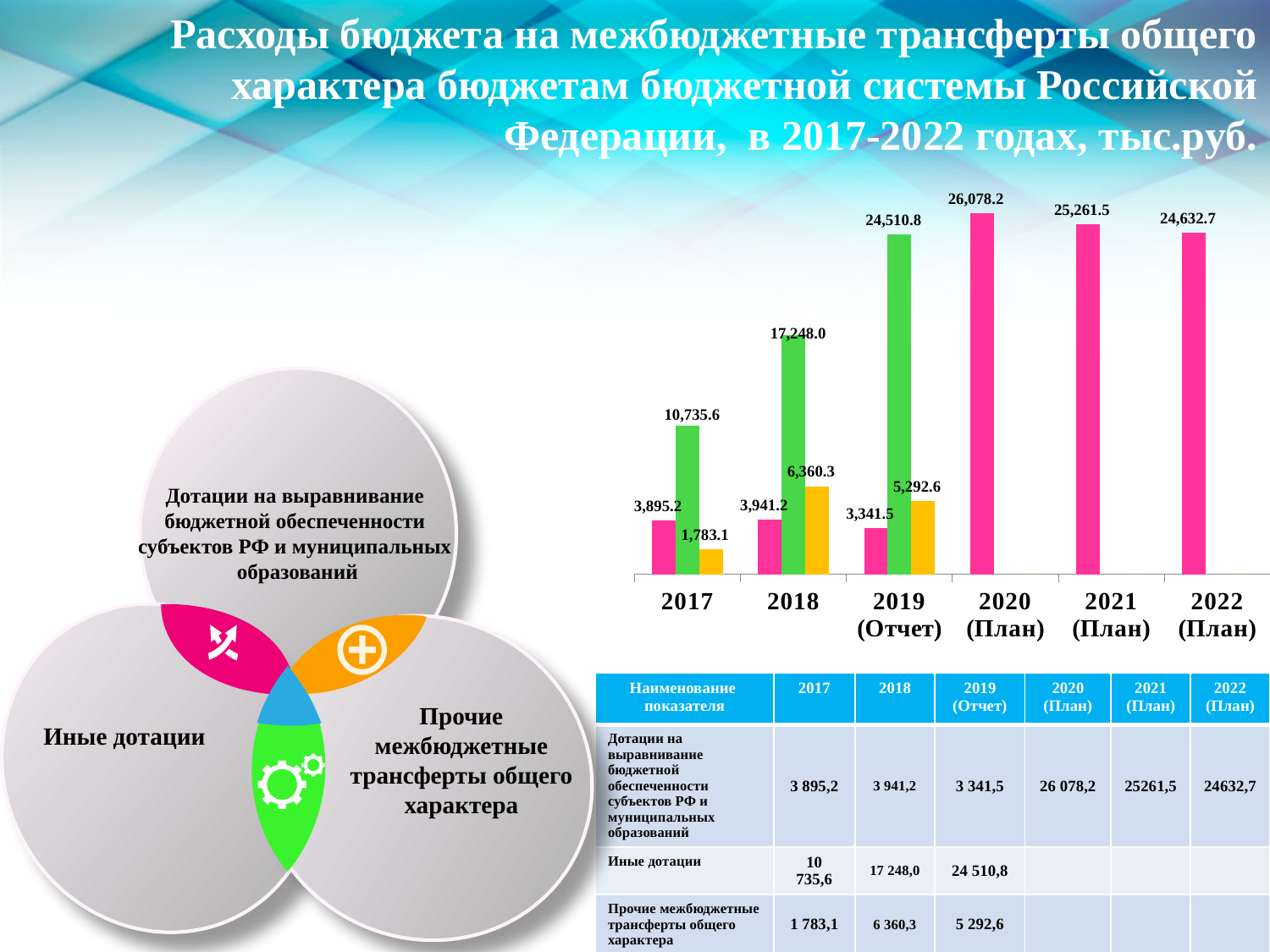
How many year categories are shown on the x axis of the chart? 6 What is the total of the three bars for 2017? 16,413.9 Which is larger: the pink bar for 2021 (План) or the pink bar for 2022 (План)? 2021 (План) Which year has the highest pink bar? 2020 (План) Do the green bar values rise or fall from 2017 to 2019 (Отчет)? rise What kind of chart is shown on the slide? bar chart What is the value of the yellow bar for 2018? 6,360.3 What is the value of the green bar for 2017? 10,735.6 Which year has the lowest yellow bar? 2017 What is the value of the pink bar for 2019 (Отчет)? 3,341.5 What is the difference between the green bar values for 2019 (Отчет) and 2018? 7,262.8 What is the value of the pink bar for 2020 (План)? 26,078.2